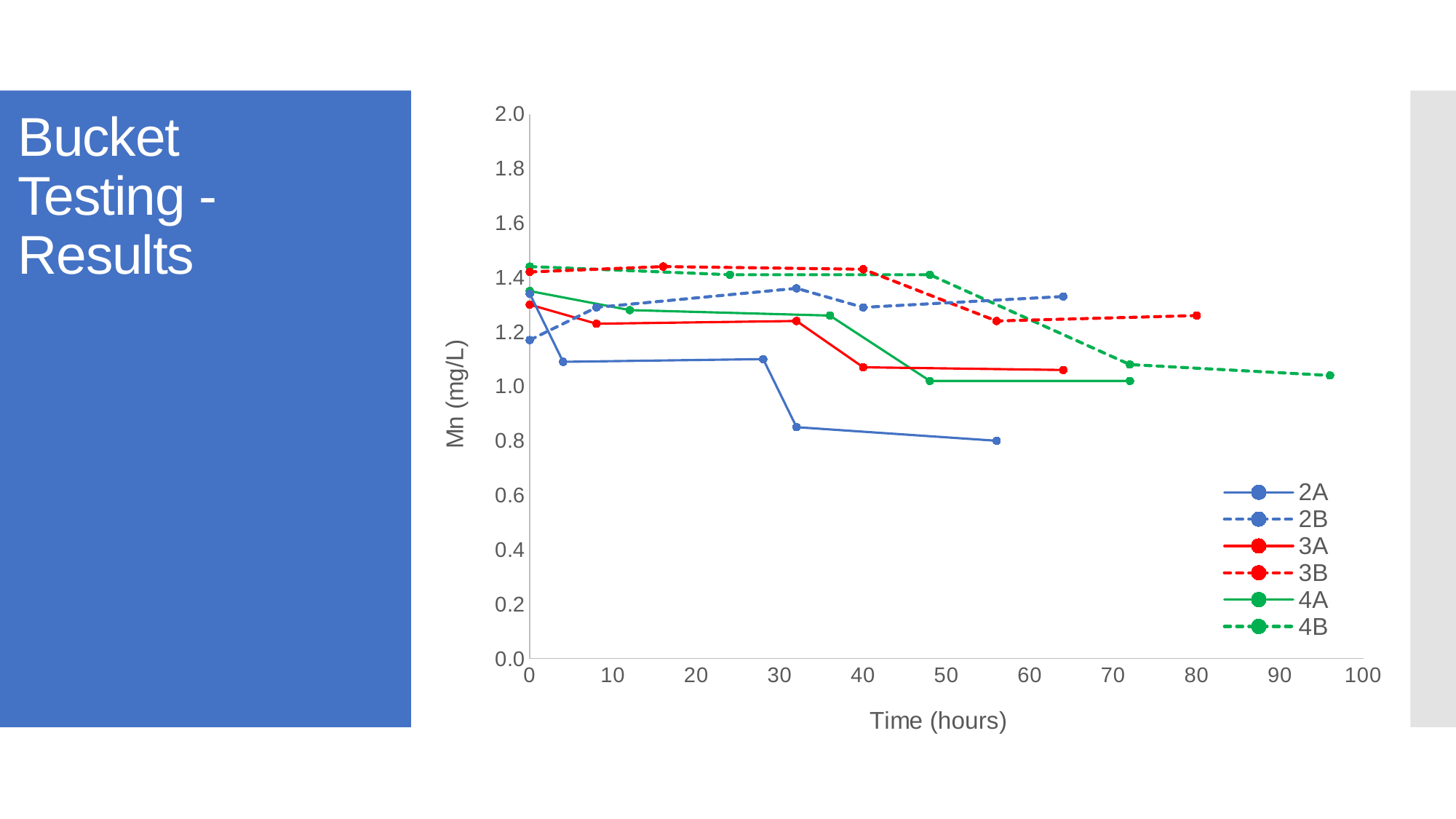
What is the label of the x axis? Time (hours) Is the final value of series 3B (at about 80 hours) greater or less than 1.2? greater Which series ends at the lowest Mn value? 2A Is the value of series 2A at about 32 hours greater or less than 1.0? less Does the Mn value for series 2A rise or fall over time? fall Is the final value of series 2B (at about 64 hours) greater or less than 1.2? greater What kind of chart is shown on the slide? line chart How many series does the legend list? 6 How many data points are plotted for series 2A? 5 What is the label of the y axis? Mn (mg/L) At their final points, which series has the higher Mn value, 2A or 2B? 2B